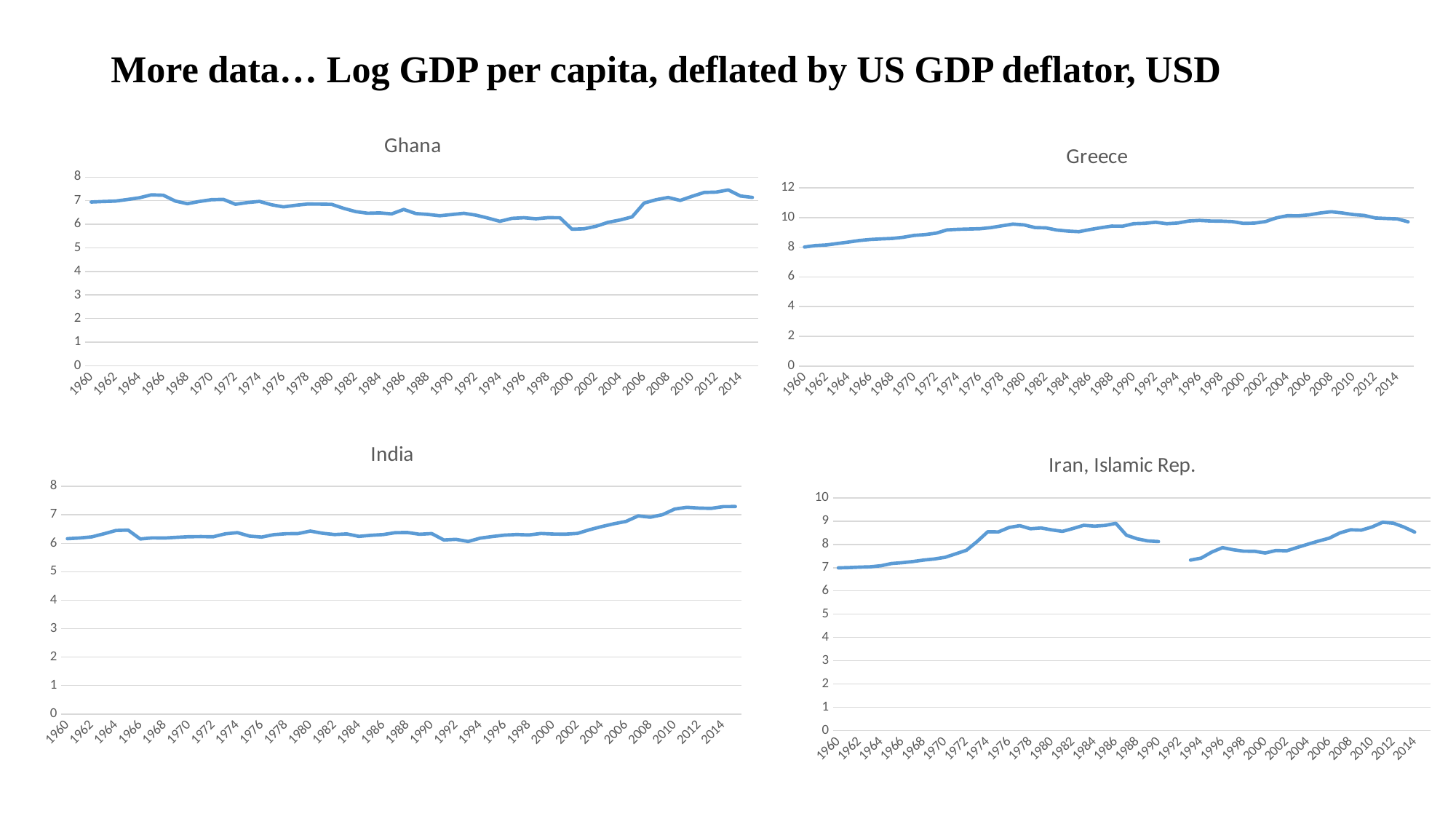
In the Greece chart, do the values generally rise or fall from 1960 to 2014? rise In the Greece chart, is the value for 1960 greater or less than 10? less What is the title of the bottom-right chart? Iran, Islamic Rep. Which chart shows the larger value for 2014, the Ghana chart or the Greece chart? Greece In the Greece chart, which year has the larger value, 1960 or 2014? 2014 In the Iran, Islamic Rep. chart, is the value for 1960 greater or less than 8? less In the Iran, Islamic Rep. chart, is the value for 1976 greater or less than 8? greater In the India chart, do the values generally rise or fall from 1990 to 2014? rise What kind of chart is the Ghana chart? line chart How many charts are shown on the slide? 4